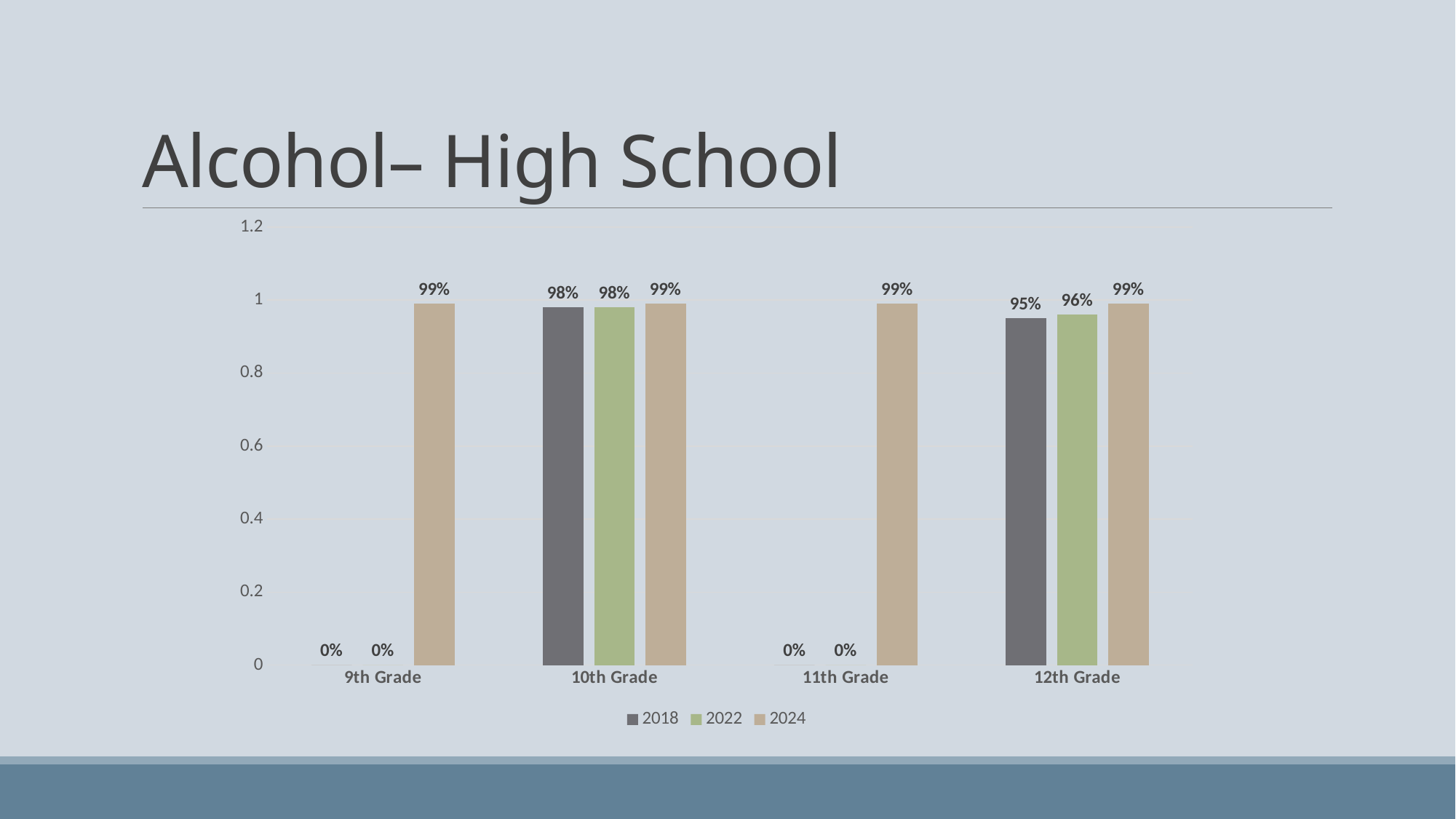
What is the difference between the 2024 and 2018 values for 12th Grade? 4% What is the value for 9th Grade in the 2022 series? 0% What is the value for 12th Grade in the 2018 series? 95% How many grade categories are shown on the x axis? 4 What is the title of the slide? Alcohol– High School Which is larger for 12th Grade: the 2018 value or the 2022 value? 2022 Which grade has the lowest value in the 2018 series among grades with a non-zero value? 12th Grade Which years are listed in the legend? 2018, 2022, 2024 What is the value for 10th Grade in the 2024 series? 99% What is the value for 12th Grade in the 2022 series? 96% What kind of chart is shown on the slide? Bar chart How many series does the legend list? 3